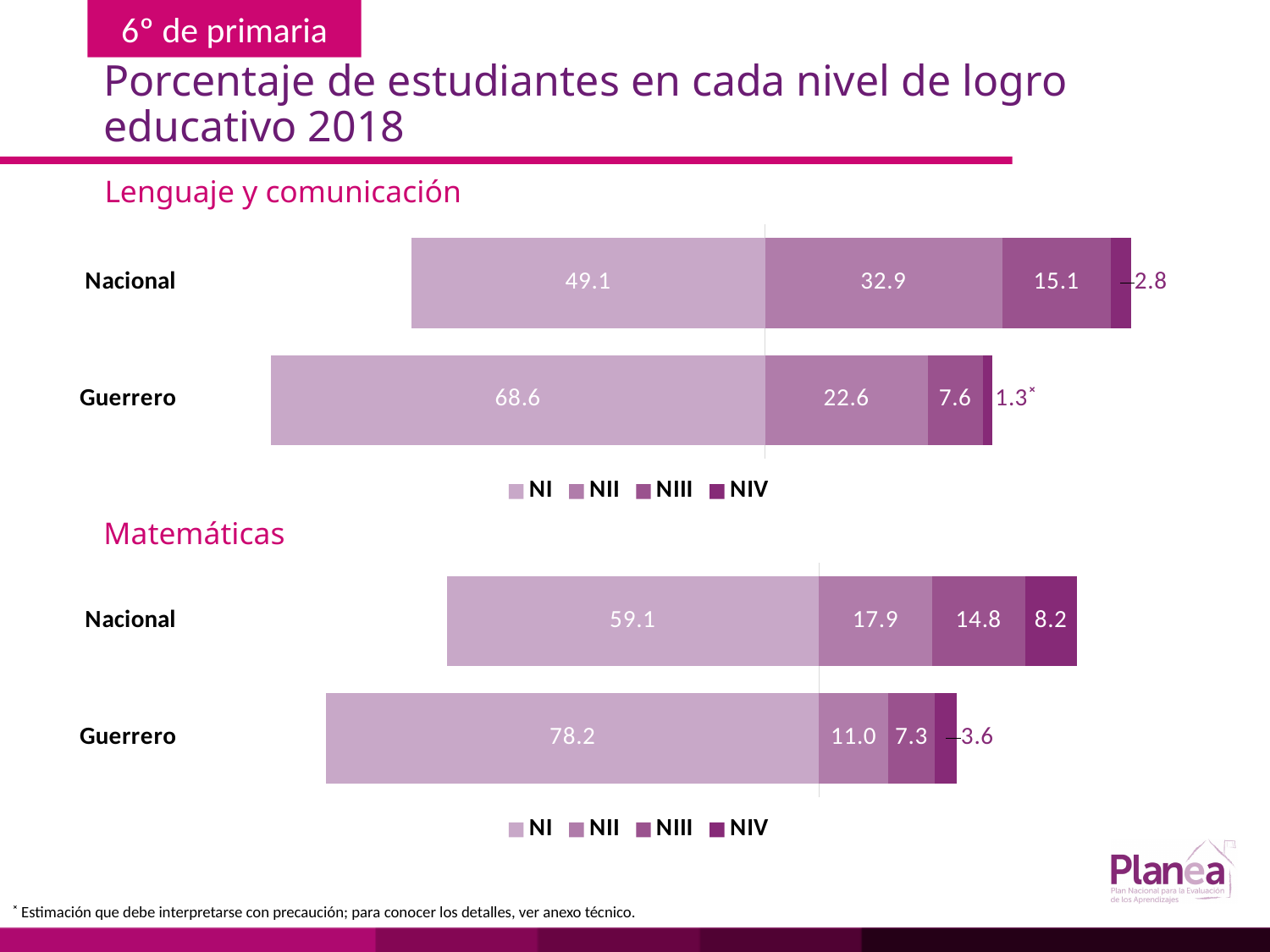
In the Matemáticas chart, what is the NIV value for Nacional? 8.2 In the Matemáticas chart, what is the difference between the NIII values for Nacional and Guerrero? 7.5 How many series does the legend of the Lenguaje y comunicación chart list? 4 In the Matemáticas chart, which is larger: the NII value for Nacional or the NII value for Guerrero? Nacional In the Lenguaje y comunicación chart, which level has the lowest value for Nacional? NIV What kind of chart is the Matemáticas chart? Stacked bar chart In the Matemáticas chart, what is the NII value for Guerrero? 11.0 In the Lenguaje y comunicación chart, what is the difference between the NI values for Guerrero and Nacional? 19.5 In the Matemáticas chart, what is the total of the stacked bar for Nacional? 100.0 In the Lenguaje y comunicación chart, what is the NI value for Guerrero? 68.6 In the Lenguaje y comunicación chart, what is the NII value for Nacional? 32.9 In the Matemáticas chart, which level has the highest value for Guerrero? NI